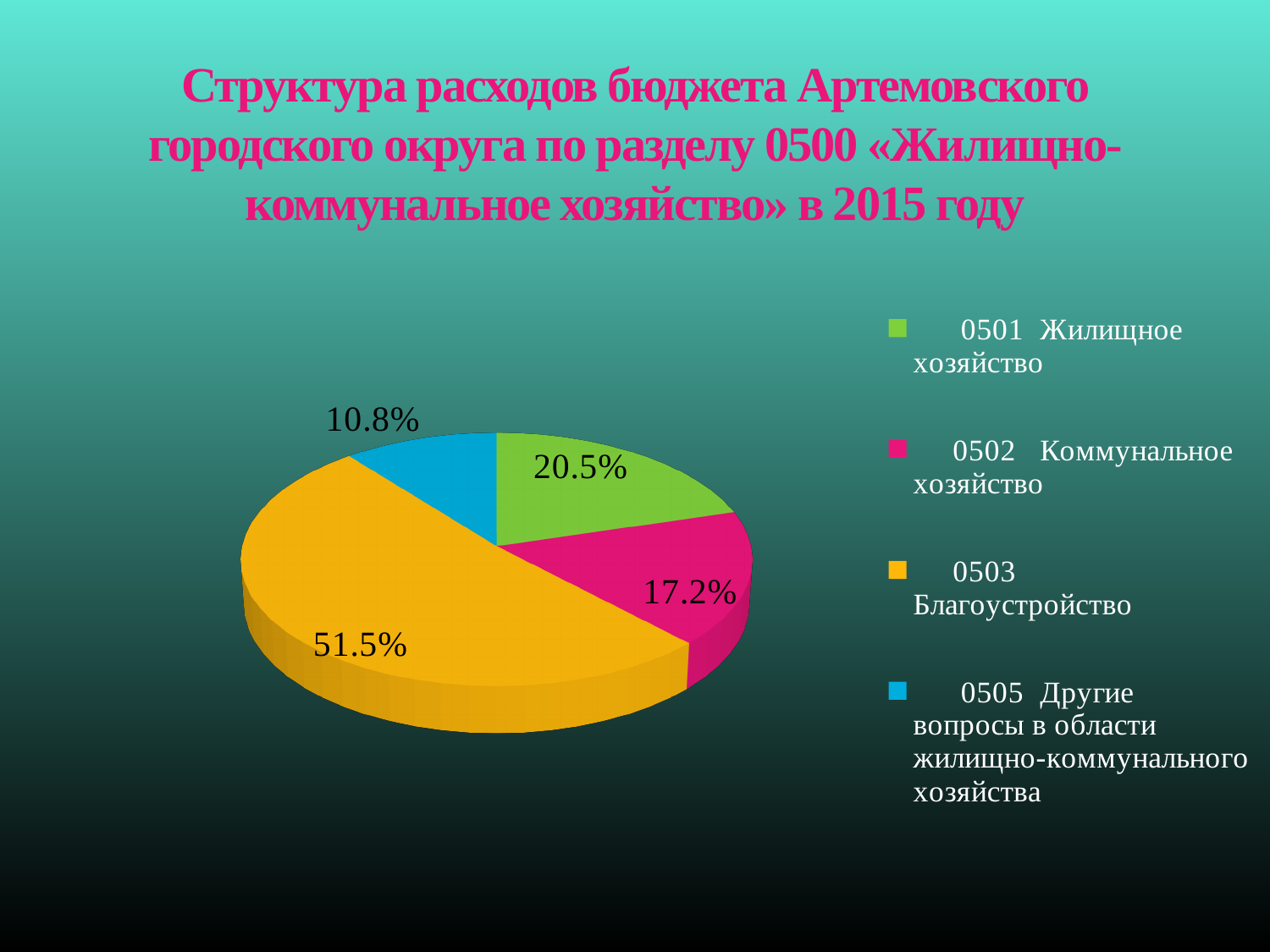
What is the difference between the shares of 0501 Жилищное хозяйство and 0502 Коммунальное хозяйство? 3.3% What kind of chart is shown on the slide? pie chart Which is larger: the share of 0502 Коммунальное хозяйство or 0505 Другие вопросы в области жилищно-коммунального хозяйства? 0502 Коммунальное хозяйство How many slices does the pie chart have? 4 What colour is the slice for 0503 Благоустройство? yellow Which category has the smallest slice of the pie? 0505 Другие вопросы в области жилищно-коммунального хозяйства What is the difference between the shares of 0503 Благоустройство and 0501 Жилищное хозяйство? 31.0% What share of the pie does 0503 Благоустройство have? 51.5% Which category has the largest slice of the pie? 0503 Благоустройство What share of the pie does 0505 Другие вопросы в области жилищно-коммунального хозяйства have? 10.8% What share of the pie does 0502 Коммунальное хозяйство have? 17.2% What share of the pie does 0501 Жилищное хозяйство have? 20.5%